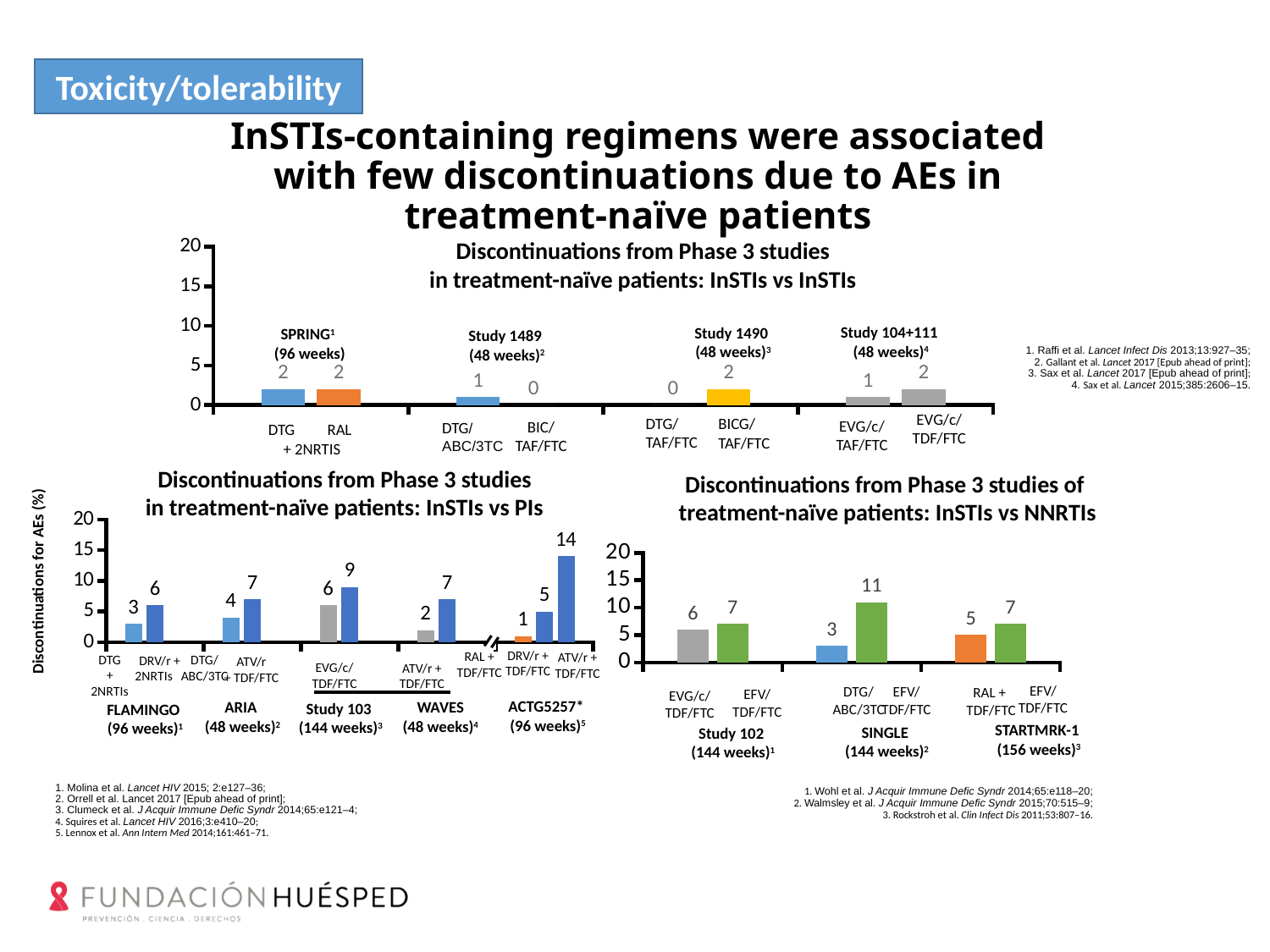
In the 'InSTIs vs PIs' chart, which is larger in FLAMINGO: DTG + 2NRTIs or DRV/r + 2NRTIs? DRV/r + 2NRTIs In the 'InSTIs vs NNRTIs' chart, which bar has the lowest value? DTG/ABC/3TC (SINGLE) In the 'InSTIs vs NNRTIs' chart, how many bars are plotted? 6 In the 'InSTIs vs PIs' chart, what is the difference between ATV/r + TDF/FTC and EVG/c/TDF/FTC in Study 103? 3 In the 'InSTIs vs InSTIs' chart, what is the value for BIC/TAF/FTC in Study 1489? 0 In the 'InSTIs vs PIs' chart, what is the value for ATV/r + TDF/FTC in ACTG5257? 14 In the 'InSTIs vs InSTIs' chart, what is the value for RAL in the SPRING study? 2 In the 'InSTIs vs InSTIs' chart, what is the value for EVG/c/TAF/FTC in Study 104+111? 1 What type of chart is the 'InSTIs vs PIs' chart? Bar chart In the 'InSTIs vs PIs' chart, which bar has the highest value? ATV/r + TDF/FTC (ACTG5257) In the 'InSTIs vs NNRTIs' chart, what is the value for EFV/TDF/FTC in the SINGLE study? 11 In the 'InSTIs vs NNRTIs' chart, what is the difference between EFV/TDF/FTC and DTG/ABC/3TC in the SINGLE study? 8